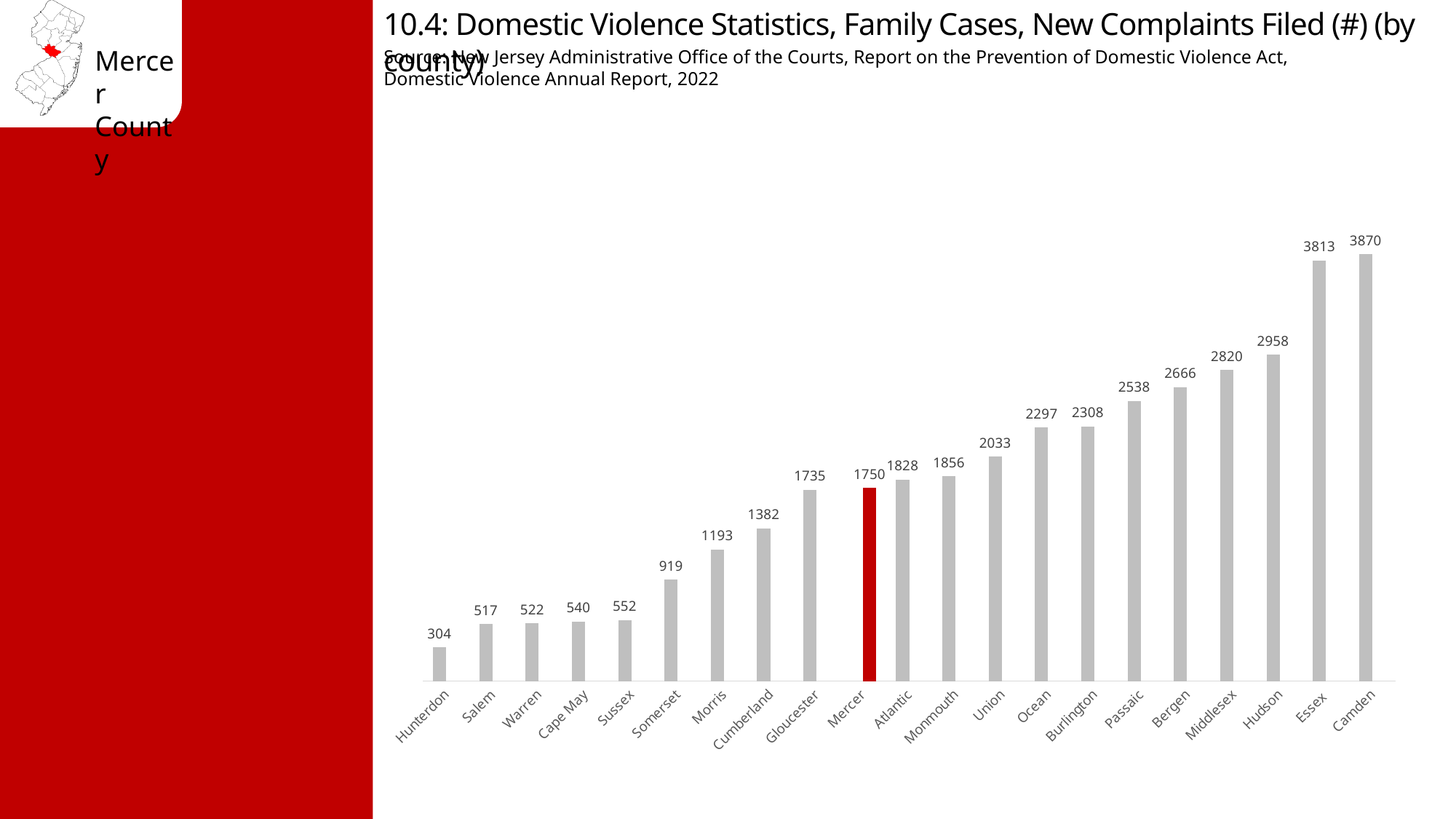
Which county's bar is highlighted in red? Mercer What is the value shown for Hunterdon? 304 What is the number of new domestic violence complaints filed in Mercer County? 1750 What kind of chart is shown on the slide? Bar chart How many counties are shown on the chart? 21 Which has a larger value, Gloucester or Cumberland? Gloucester What is the value shown for Camden? 3870 What is the difference between the values for Mercer and Hunterdon? 1446 What is the difference between the values for Essex and Camden? 57 Which county has the lowest number of new complaints filed? Hunterdon Which county has the highest number of new complaints filed? Camden Do the values rise or fall moving from left to right along the x axis? Rise